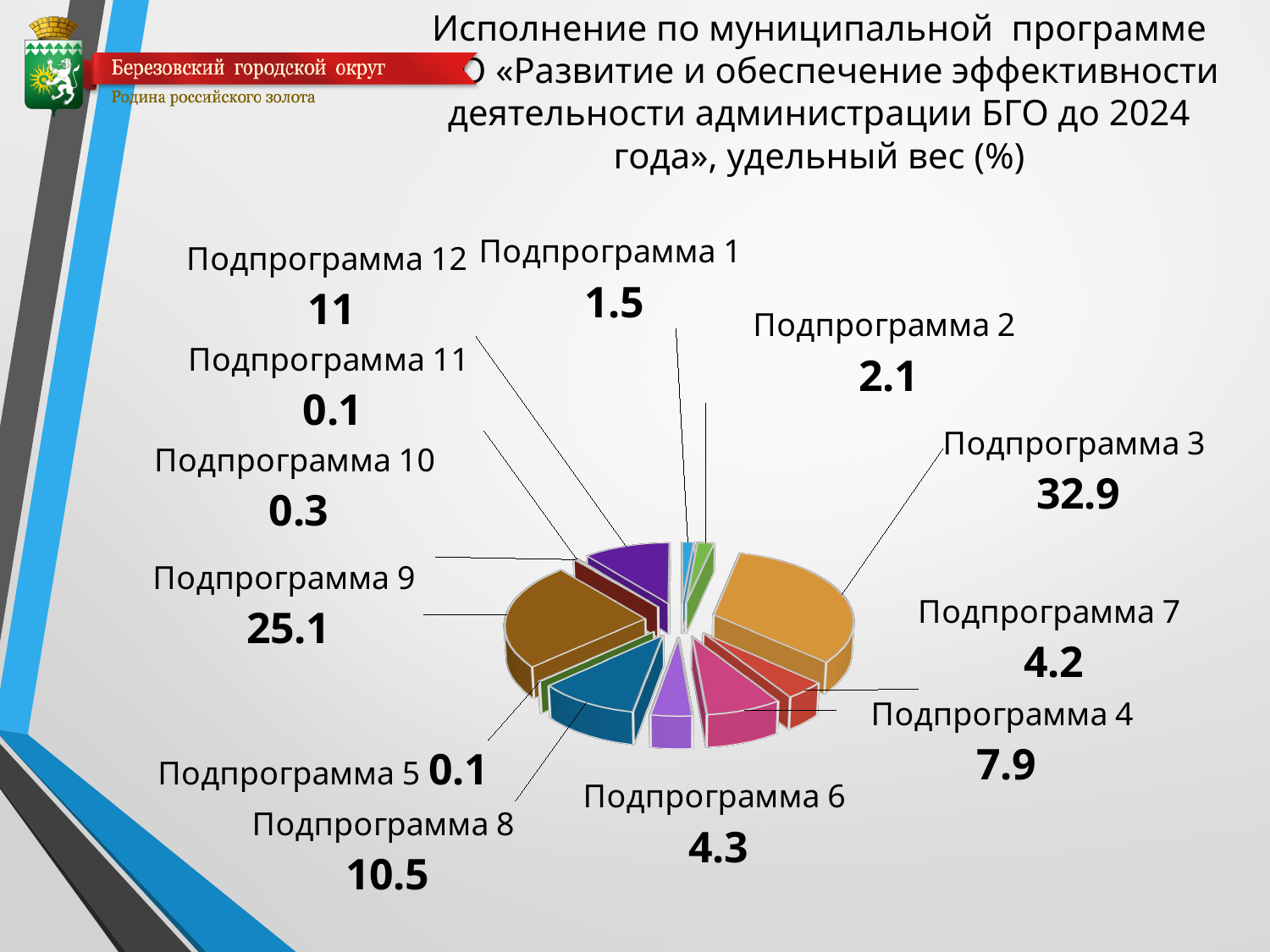
What is the value for Подпрограмма 10? 0.3 What is the value for Подпрограмма 9? 25.1 What is the value for Подпрограмма 3? 32.9 What is the value for Подпрограмма 12? 11 What is the difference between the values for Подпрограмма 3 and Подпрограмма 9? 7.8 Which subprogram has the largest share of the pie? Подпрограмма 3 What unit does the chart title say the values are expressed in? удельный вес (%) How many subprograms (slices) are shown in the pie chart? 12 What is the value for Подпрограмма 8? 10.5 What is the difference between the values for Подпрограмма 12 and Подпрограмма 8? 0.5 What type of chart is shown on the slide? pie chart Which is larger, the value for Подпрограмма 4 or the value for Подпрограмма 7? Подпрограмма 4